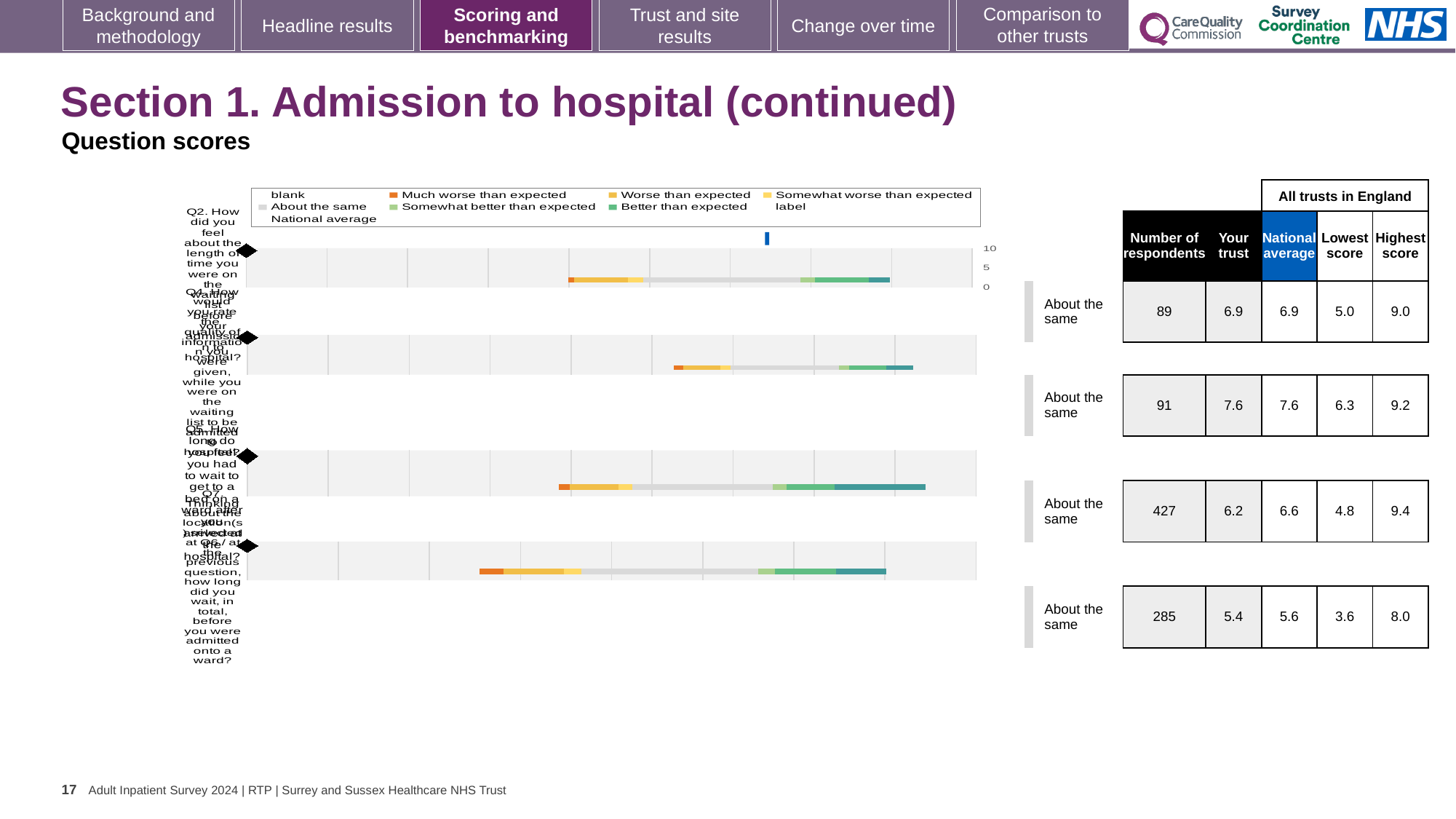
How many question rows (bars) are plotted in the chart? 4 Which row in the table has the lowest 'Your trust' score? the fourth row (5.4) In the table next to the chart, what is the number of respondents for the first (top) row? 89 For the third row, what is the difference between the national average and the 'Your trust' score? 0.4 What benchmark category label is shown beside each of the four rows? About the same In the table next to the chart, what is the national average for the third row? 6.6 Is the 'Your trust' score higher for the first row or the fourth row? the first row In the table next to the chart, what is the highest score for the second row? 9.2 Which row in the table has the highest number of respondents? the third row (427) In the table next to the chart, what is the 'Your trust' score for the second row? 7.6 What kind of chart is shown on the slide? bar chart In the table next to the chart, what is the lowest score for the fourth (bottom) row? 3.6